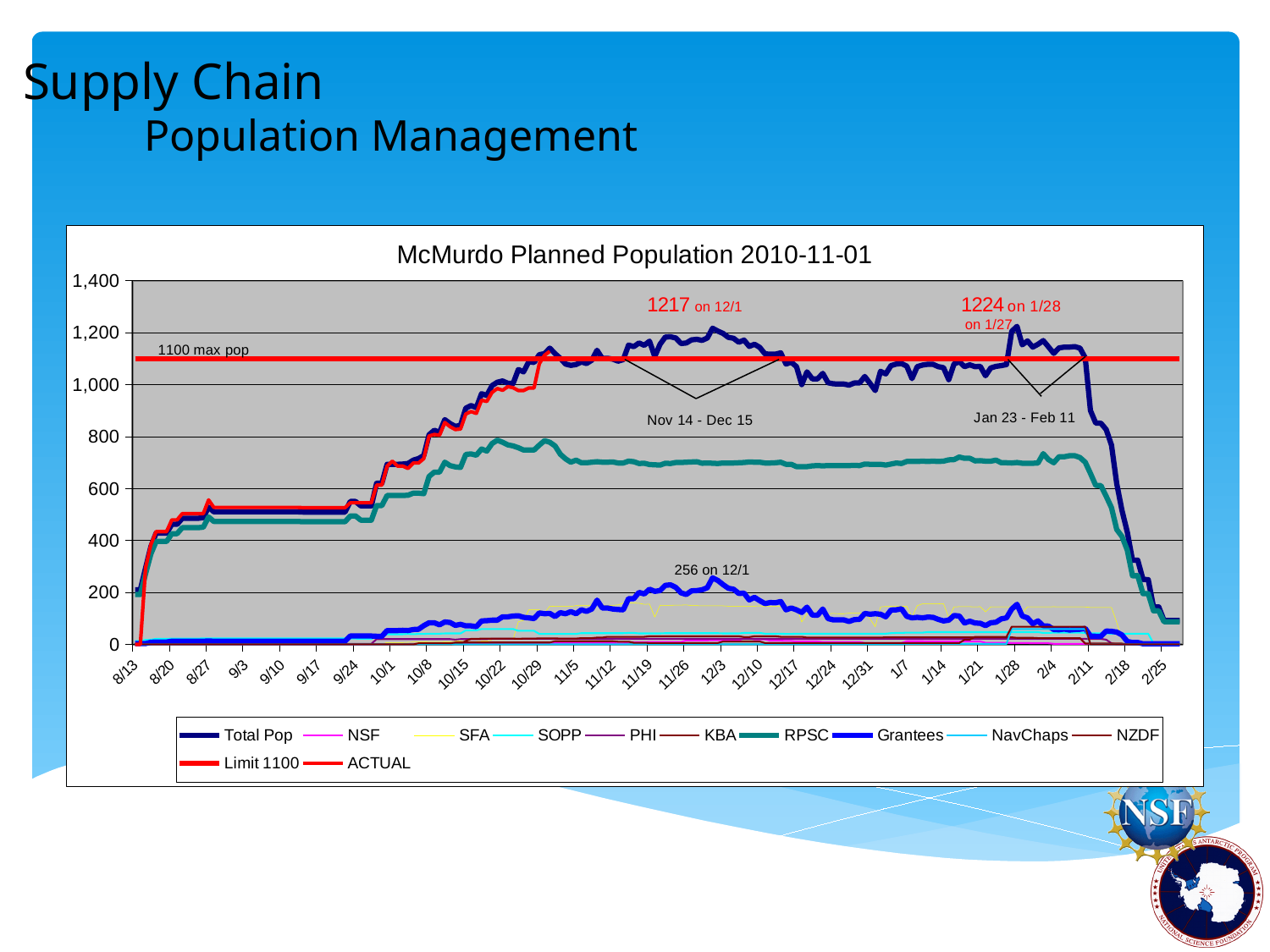
Does the Total Pop line rise or fall between 8/13 and 10/29? rise What kind of chart is shown on the slide? line chart What is the labelled peak value of Total Pop on 1/28? 1224 What is the labelled value of Grantees on 12/1? 256 What is the title of the chart? McMurdo Planned Population 2010-11-01 What population limit is marked by the horizontal red line? 1100 Is the value for RPSC on 12/24 greater or less than 800? less How many series does the chart legend list? 12 Which labelled Total Pop peak is larger, the one on 12/1 or the one on 1/28? 1/28 By how much does the labelled Total Pop peak of 1217 on 12/1 exceed the 1100 max pop limit? 117 What is the labelled peak value of Total Pop on 12/1? 1217 What is the difference between the labelled Total Pop peaks on 1/28 (1224) and 12/1 (1217)? 7